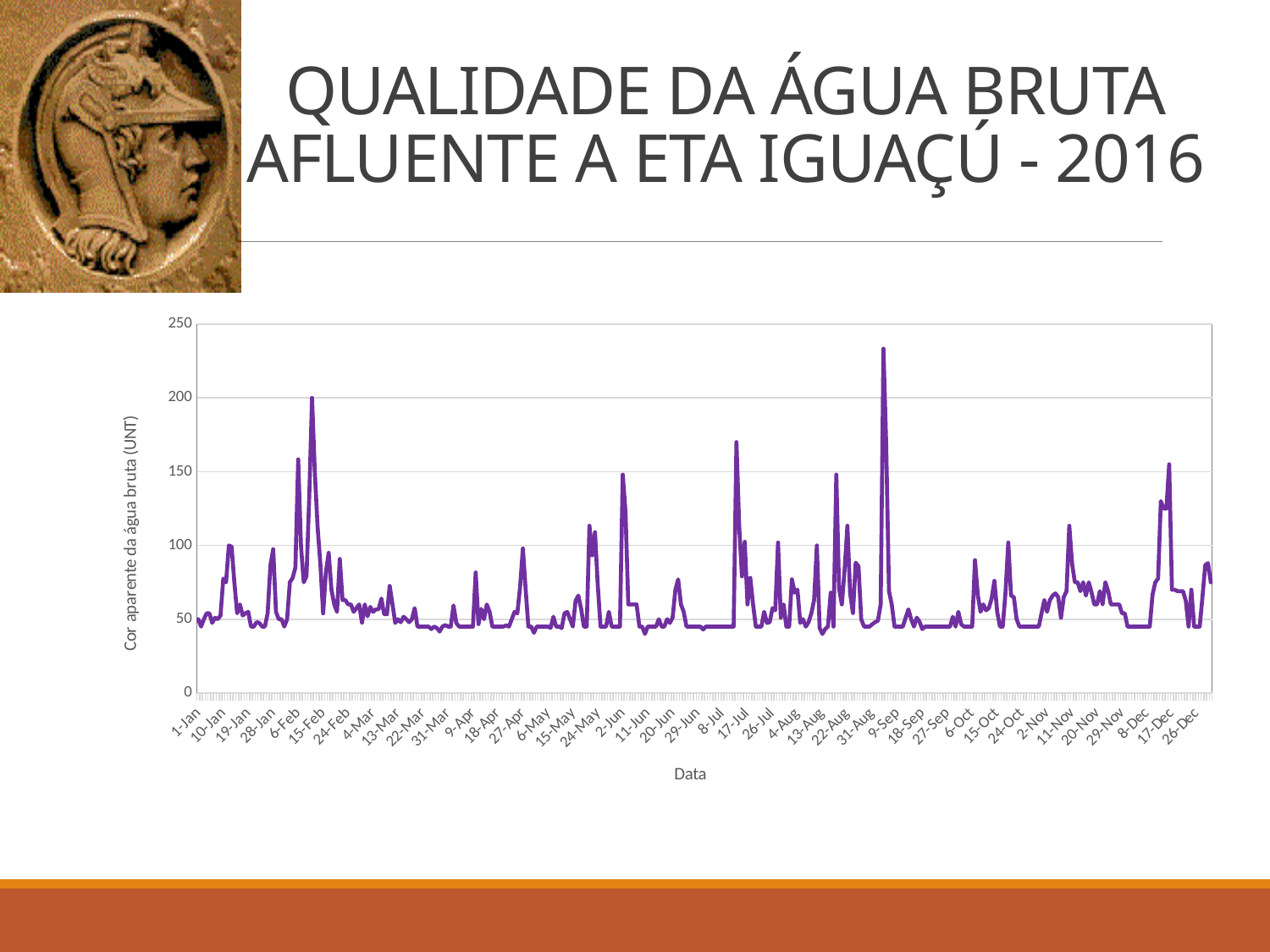
Is the highest peak of the line (near 9-Sep) greater or less than 200? greater What kind of chart is shown on the slide? line chart Is the value at 18-Sep greater or less than 100? less Is the highest peak of the line greater or less than 250? less Which is larger, the peak near 9-Sep or the peak near 17-Jul? the peak near 9-Sep What is the title of the y-axis of the chart? Cor aparente da água bruta (UNT) What is the title of the x-axis of the chart? Data